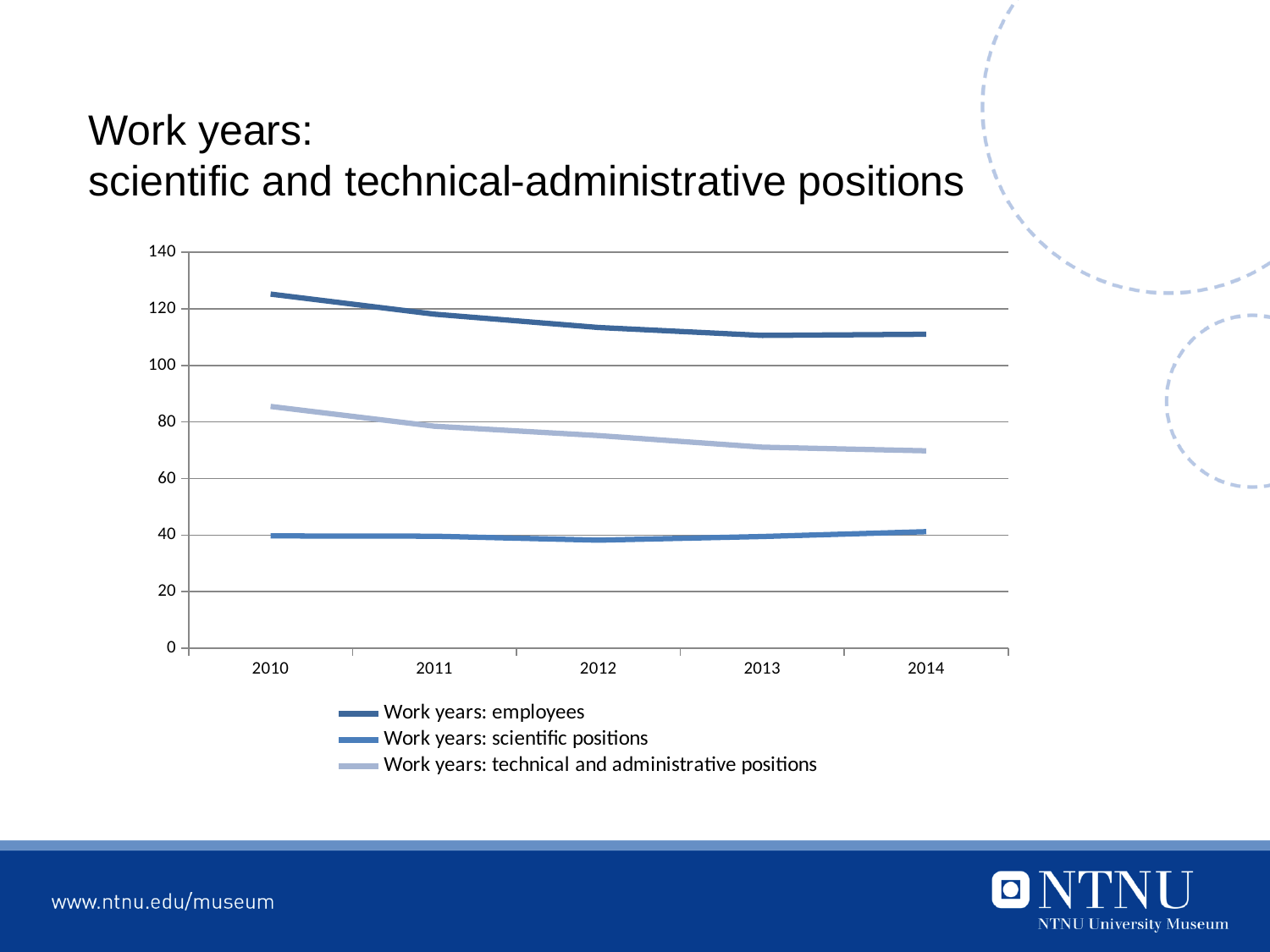
Which series has the highest values across all years? Work years: employees Is the value for Work years: scientific positions in 2010 greater or less than 60? less How many years are plotted along the x axis? 5 Is the value for Work years: technical and administrative positions in 2010 greater or less than 80? greater Is the value for Work years: employees in 2014 greater or less than 100? greater What kind of chart is shown on the slide? line chart Does the Work years: technical and administrative positions line rise or fall from 2010 to 2014? fall How many series does the legend list? 3 In 2010, which is larger: Work years: employees or Work years: technical and administrative positions? Work years: employees Which series has the lowest values across all years? Work years: scientific positions